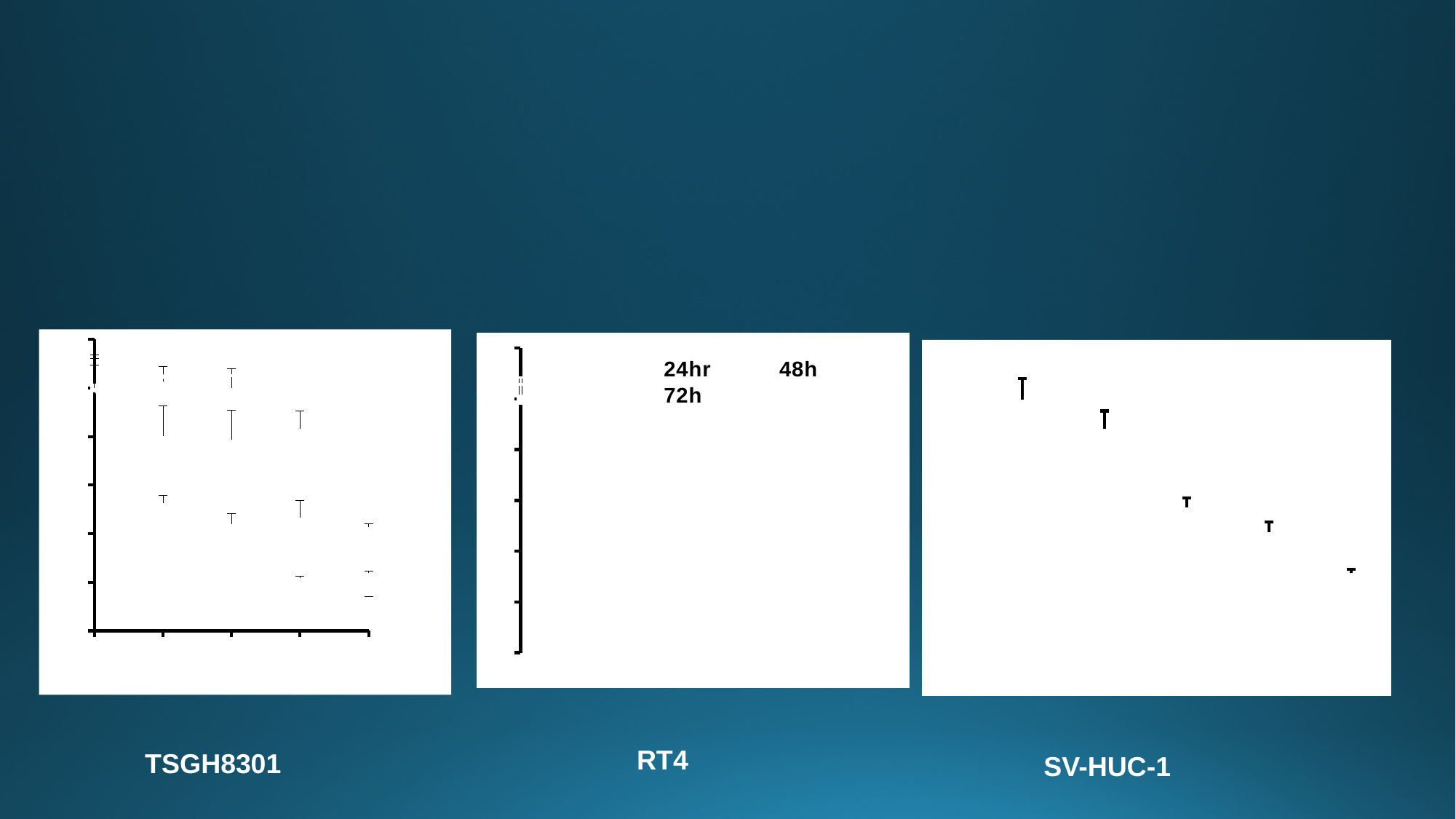
What are the labels of the three charts on the slide, from left to right? TSGH8301, RT4, SV-HUC-1 In the SV-HUC-1 chart, do the plotted points rise or fall from left to right? fall How many series does the legend list in the RT4 chart? 3 What are the legend entries shown in the RT4 chart? 24hr, 48h, 72h